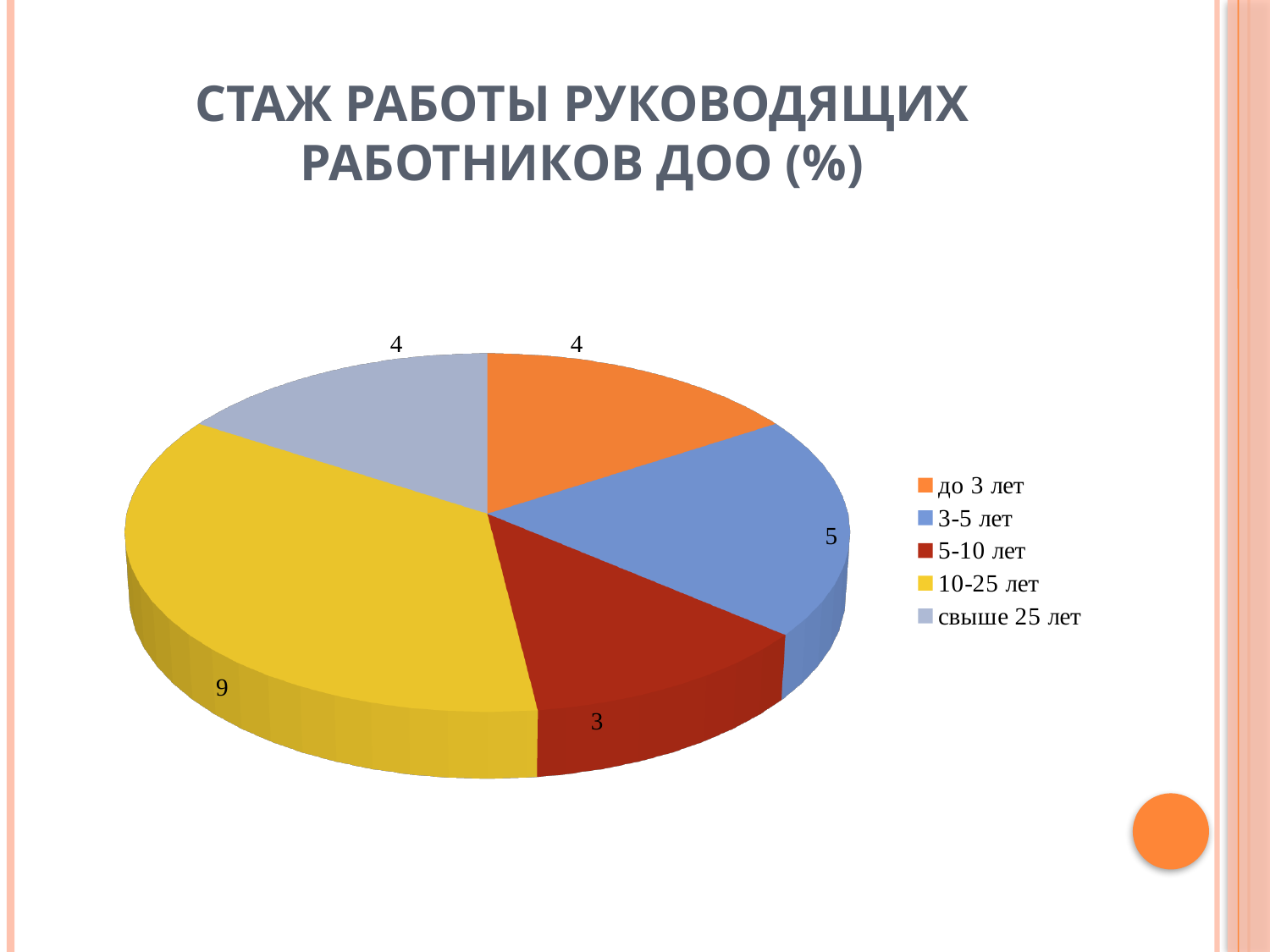
What is the value for the "10-25 лет" slice? 9 Which is larger, the value for "3-5 лет" or the value for "5-10 лет"? 3-5 лет What is the difference between the values for "10-25 лет" and "3-5 лет"? 4 What is the value for the "5-10 лет" slice? 3 How many categories does the legend list? 5 What is the value for the "3-5 лет" slice? 5 What is the value for the "до 3 лет" slice? 4 Which category has the smallest slice? 5-10 лет What share of the pie does the "10-25 лет" slice represent? 36% Which category has the largest slice? 10-25 лет What kind of chart is shown on the slide? pie chart What is the title of the chart? СТАЖ РАБОТЫ РУКОВОДЯЩИХ РАБОТНИКОВ ДОО (%)